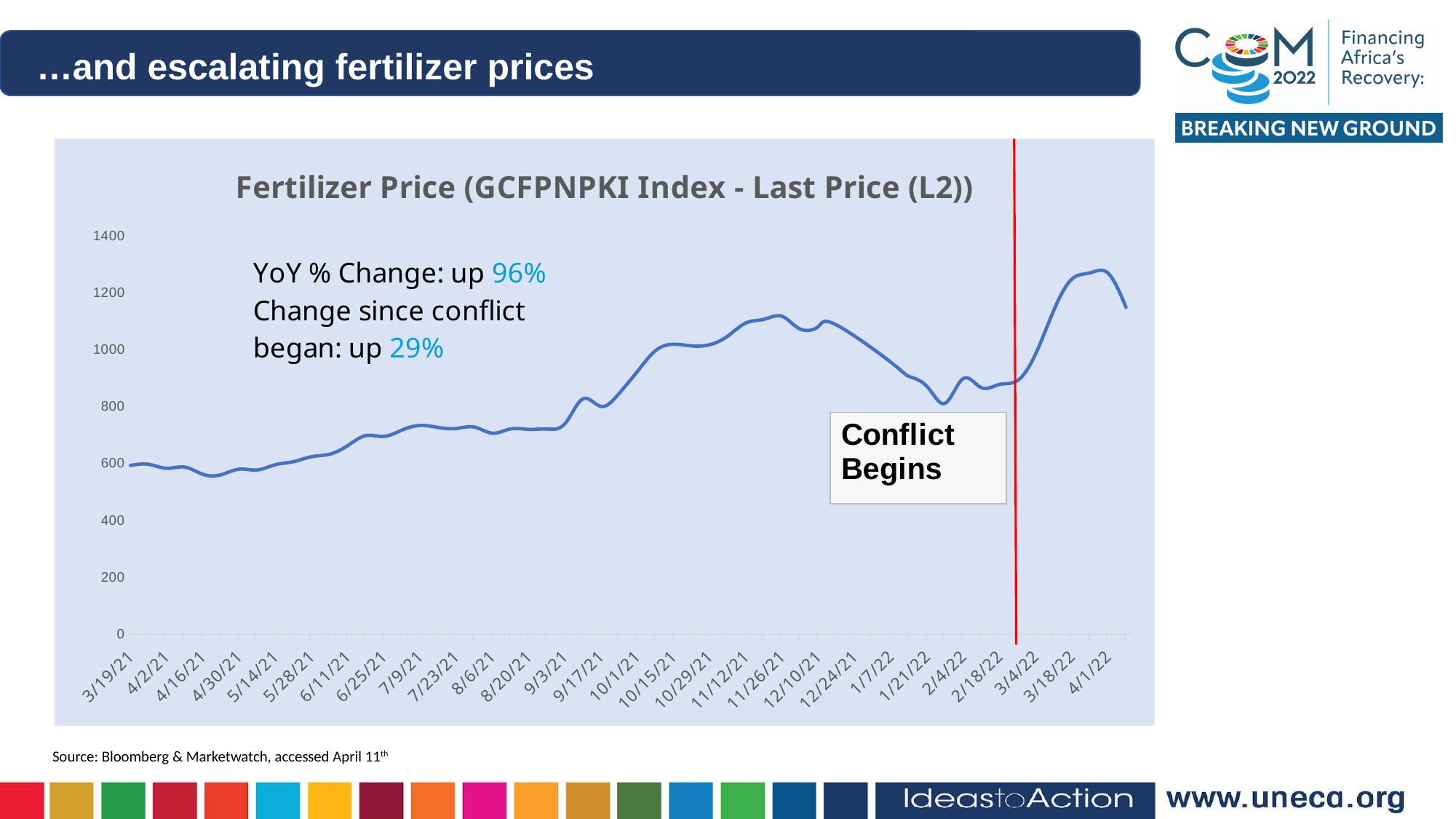
According to the annotation on the chart, what is the YoY % change in the fertilizer price? up 96% What event does the red vertical line on the chart mark? Conflict Begins Which date has the higher fertilizer price index value, 3/19/21 or 4/1/22? 4/1/22 Is the fertilizer price index value at 4/1/22 greater or less than 1200? greater How many data series are plotted in the chart? 1 What is the title of the chart? Fertilizer Price (GCFPNPKI Index - Last Price (L2)) According to the annotation on the chart, what is the change in the fertilizer price since the conflict began? up 29% Is the fertilizer price index value at 3/19/21 greater or less than 800? less Is the fertilizer price index value at 11/26/21 greater or less than 1000? greater What type of chart is shown on the slide? line chart Overall, does the fertilizer price index rise or fall from 3/19/21 to 4/1/22? rise